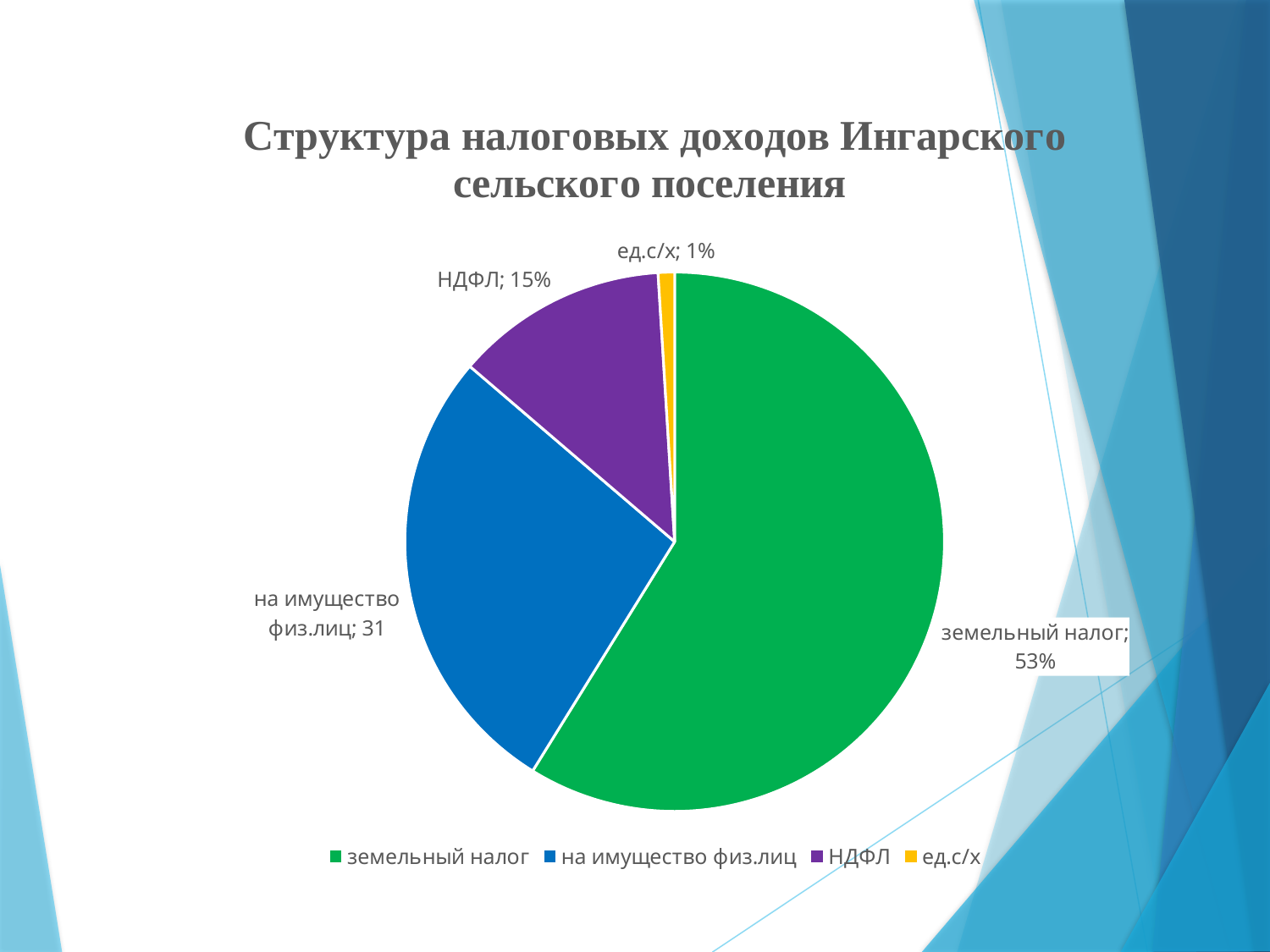
Which category has the smallest slice of the pie? ед.с/х What kind of chart is shown on the slide? pie chart Which category has the largest slice of the pie? земельный налог What is the value shown for на имущество физ.лиц? 31 What is the difference between the share for земельный налог and the share for НДФЛ? 38% What is the share for земельный налог? 53% Which is larger, the slice for НДФЛ or the slice for на имущество физ.лиц? на имущество физ.лиц How many slices does the pie chart have? 4 What is the share for НДФЛ? 15% What is the share for ед.с/х? 1% What is the title of the chart? Структура налоговых доходов Ингарского сельского поселения How many entries does the legend list? 4